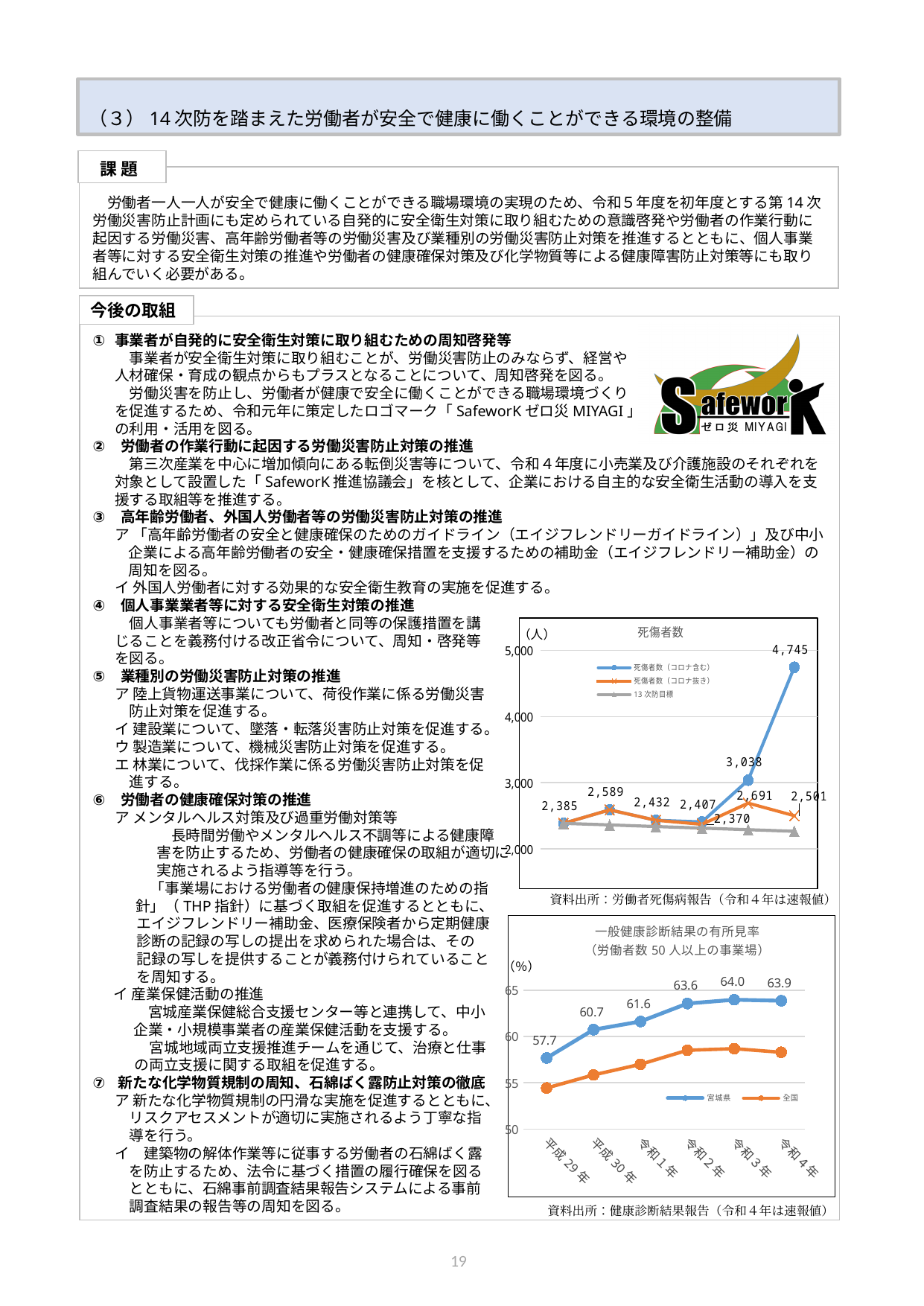
In the chart titled 一般健康診断結果の有所見率, how many years are shown on the x axis? 6 In the chart titled 一般健康診断結果の有所見率, what is the difference between the 宮城県 values for 令和4年 and 平成29年? 6.2 What kind of chart is the chart titled 死傷者数? line chart In the chart titled 一般健康診断結果の有所見率, which series has the larger value in 令和2年, 宮城県 or 全国? 宮城県 In the chart titled 一般健康診断結果の有所見率, what is the value for 宮城県 in 平成29年? 57.7 In the chart titled 一般健康診断結果の有所見率, what is the value for 宮城県 in 令和3年? 64.0 In the chart titled 一般健康診断結果の有所見率, does the 宮城県 value rise or fall from 平成29年 to 令和2年? rise In the chart titled 死傷者数, how many series does the legend list? 3 In the chart titled 一般健康診断結果の有所見率, in which year is the 宮城県 value highest? 令和3年 In the chart titled 一般健康診断結果の有所見率, is the value for 全国 in 平成29年 greater or less than 55? less In the chart titled 死傷者数, what is the highest value labelled for 死傷者数（コロナ含む）? 4,745 In the chart titled 一般健康診断結果の有所見率, how many series does the legend list? 2